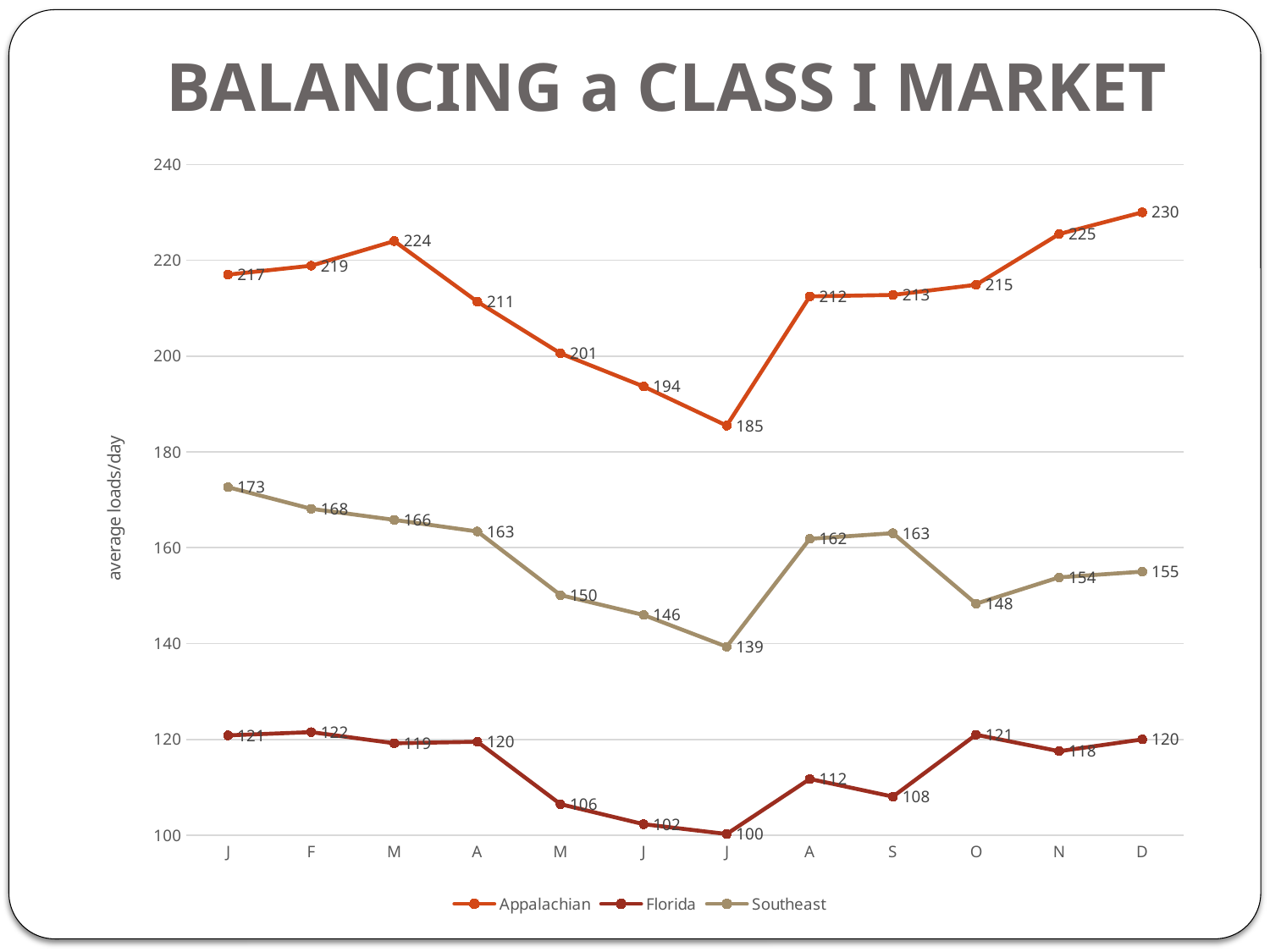
How many months are plotted along the x axis? 12 For Florida, is the value in the month labelled F larger or the value in the month labelled N? F What is the lowest value plotted for Southeast? 139 What is the value for Florida in the month labelled O? 121 What is the value for Appalachian in the last month (D)? 230 In which month does Appalachian reach its highest value? D What is the value for Southeast in the month labelled F? 168 How many series does the legend list? 3 What is the difference between the Appalachian and Southeast values in the month labelled D? 75 What is the lowest value plotted for Florida? 100 What kind of chart is shown on the slide? line chart What is the label on the vertical axis? average loads/day